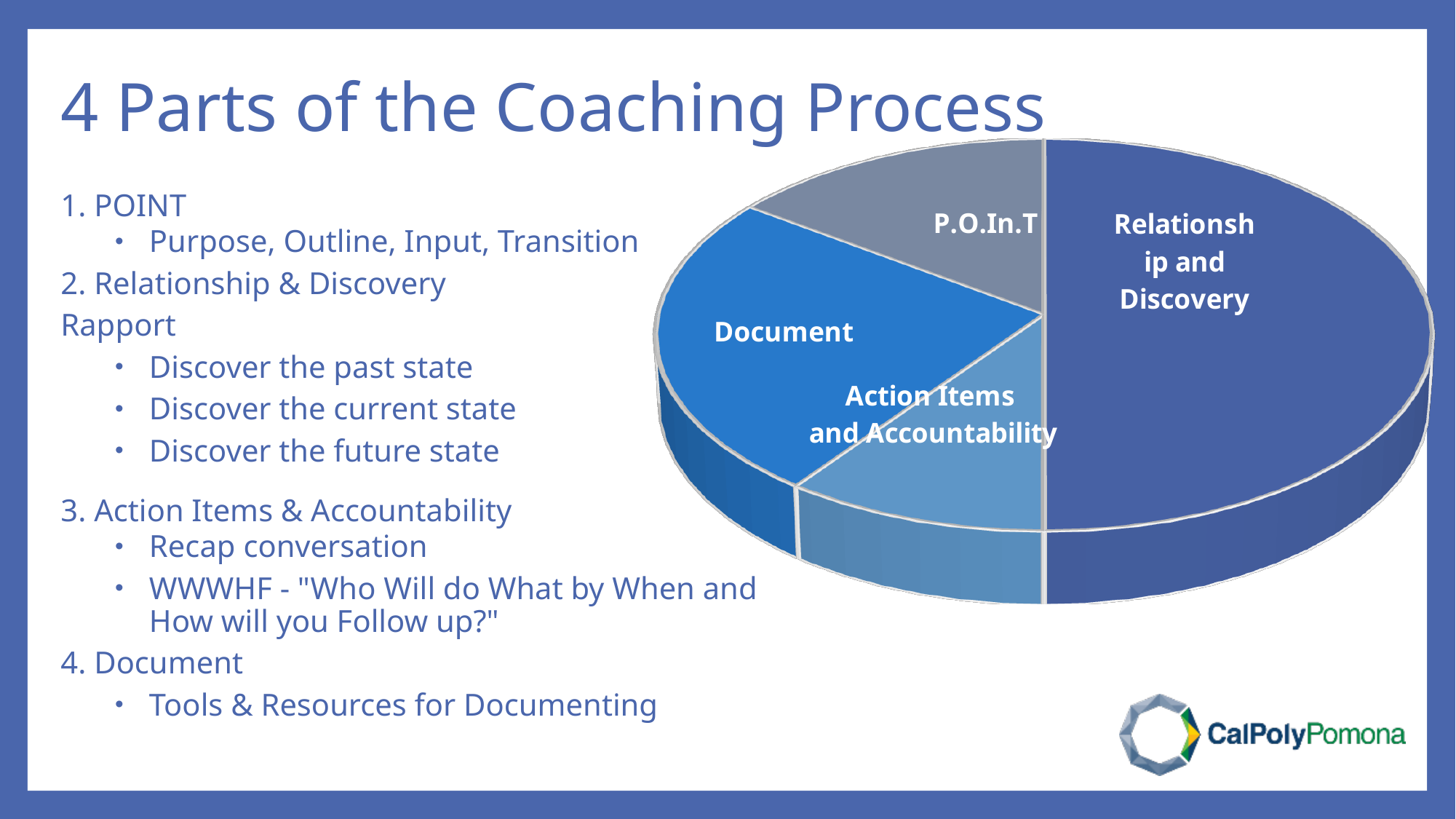
Which is larger in the pie chart, the Relationship and Discovery slice or the Document slice? Relationship and Discovery Which slice of the pie chart is labelled with the abbreviation for Purpose, Outline, Input, Transition? P.O.In.T Which is larger in the pie chart, the Relationship and Discovery slice or the Action Items and Accountability slice? Relationship and Discovery Which is larger in the pie chart, the Document slice or the P.O.In.T slice? Document What kind of chart is shown on the slide? Pie chart Which slice of the pie chart is the largest? Relationship and Discovery Which slice of the pie chart is coloured grey? P.O.In.T How many slices does the pie chart have? 4